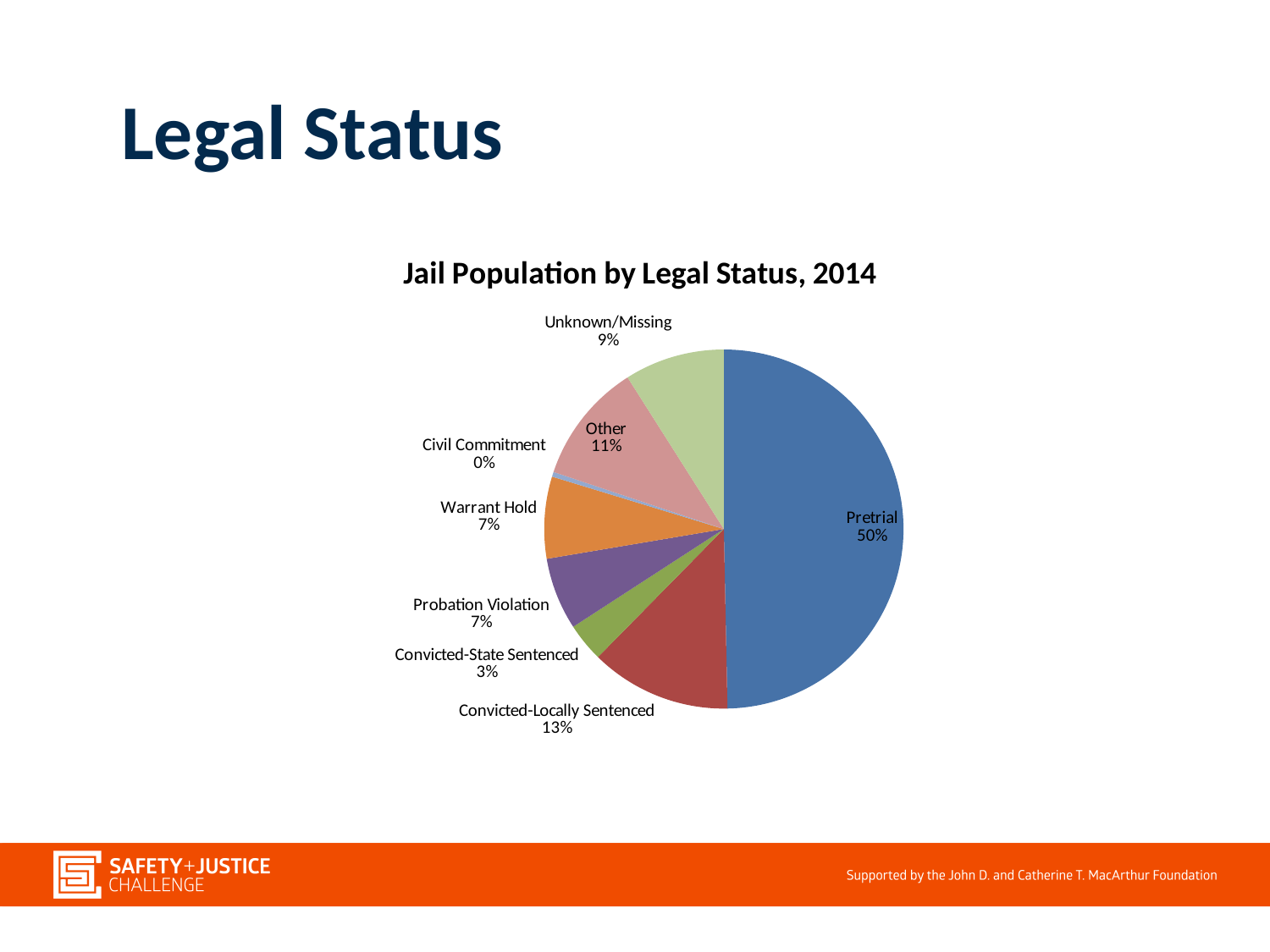
What percentage of the jail population is Convicted-Locally Sentenced? 13% What percentage is shown for Civil Commitment? 0% What share of the jail population is Pretrial? 50% What percentage is shown for Unknown/Missing? 9% Which legal status category has the largest share of the jail population? Pretrial What type of chart is shown on the slide? Pie chart Which legal status category has the smallest share of the jail population? Civil Commitment Which is larger, the share for Other or the share for Unknown/Missing? Other How many categories are shown in the pie chart? 8 What share does the Other slice represent? 11% What is the title of the chart? Jail Population by Legal Status, 2014 What is the difference in percentage points between Pretrial and Convicted-Locally Sentenced? 37